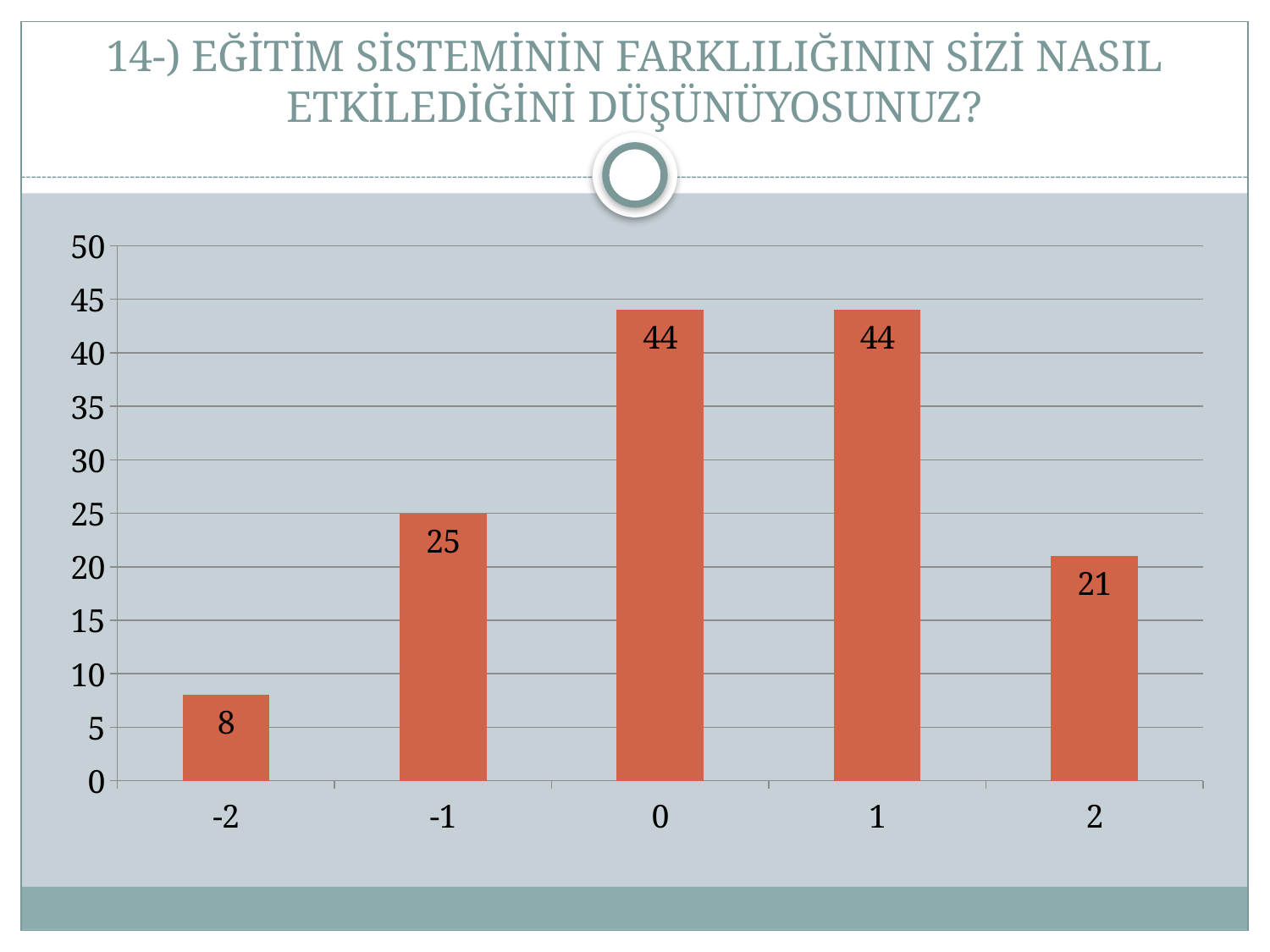
What is the difference between the values for category 0 and category -1? 19 What is the value for category 2? 21 Which is larger, the value for category -1 or the value for category 2? -1 What is the highest value shown on the vertical axis? 50 What is the value for category 0? 44 What is the value for category -1? 25 What kind of chart is shown on the slide? bar chart How many categories are shown on the x axis? 5 What is the difference between the values for category 2 and category -2? 13 Is the value for category 1 greater or less than 40? greater Which category has the lowest value? -2 What is the value for category -2? 8